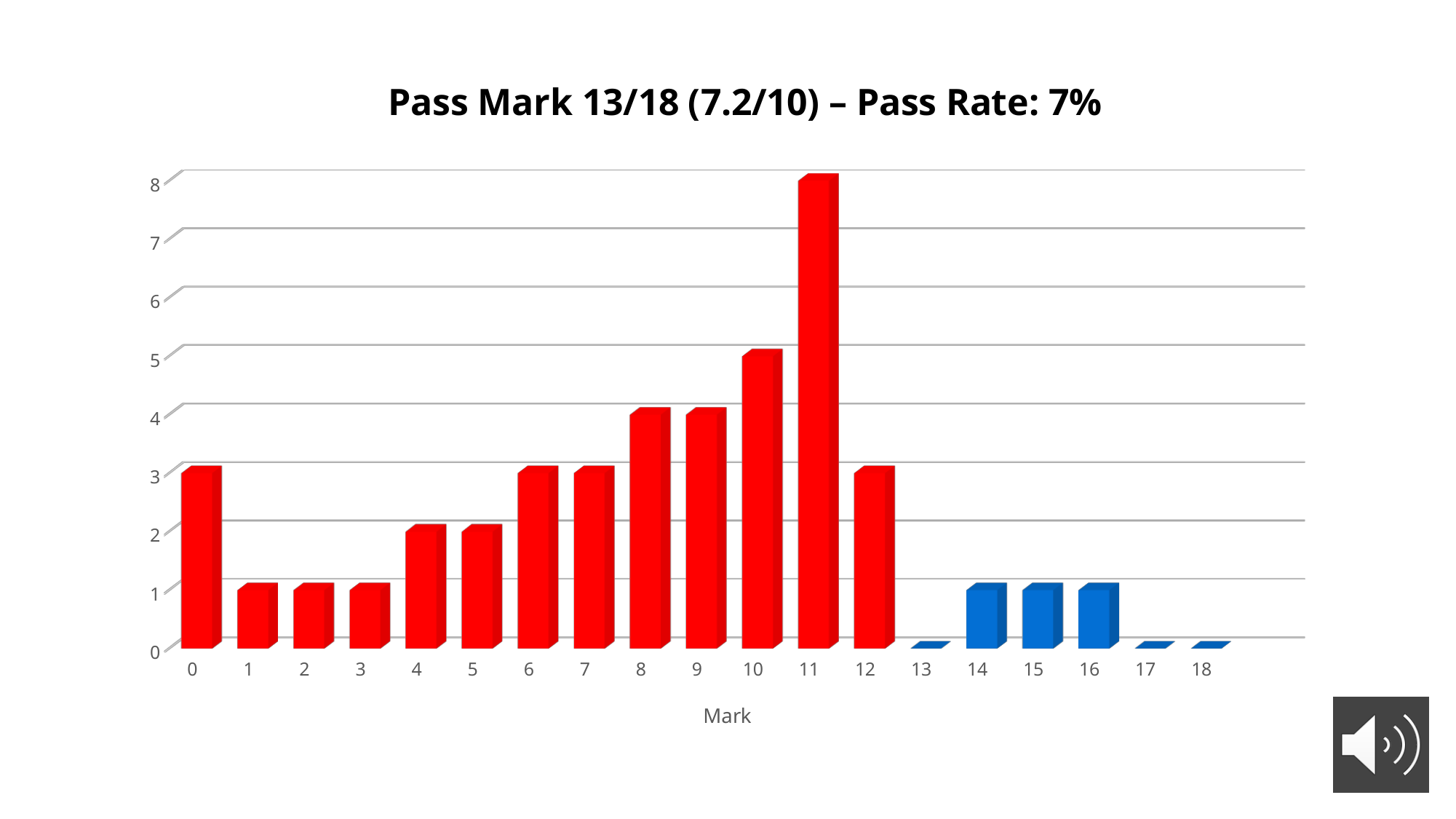
What is the value of the bar for mark 0? 3 What is the value of the bar for mark 11? 8 What is the value of the bar for mark 14? 1 How many mark categories are shown on the x axis? 19 What is the value of the bar for mark 10? 5 Is the value for mark 11 greater or less than 6? greater Which is larger, the value for mark 8 or the value for mark 12? mark 8 What is the title of the chart? Pass Mark 13/18 (7.2/10) – Pass Rate: 7% What is the difference between the values for mark 11 and mark 10? 3 Which mark has the highest bar? 11 What is the label of the x axis? Mark What type of chart is shown on the slide? bar chart